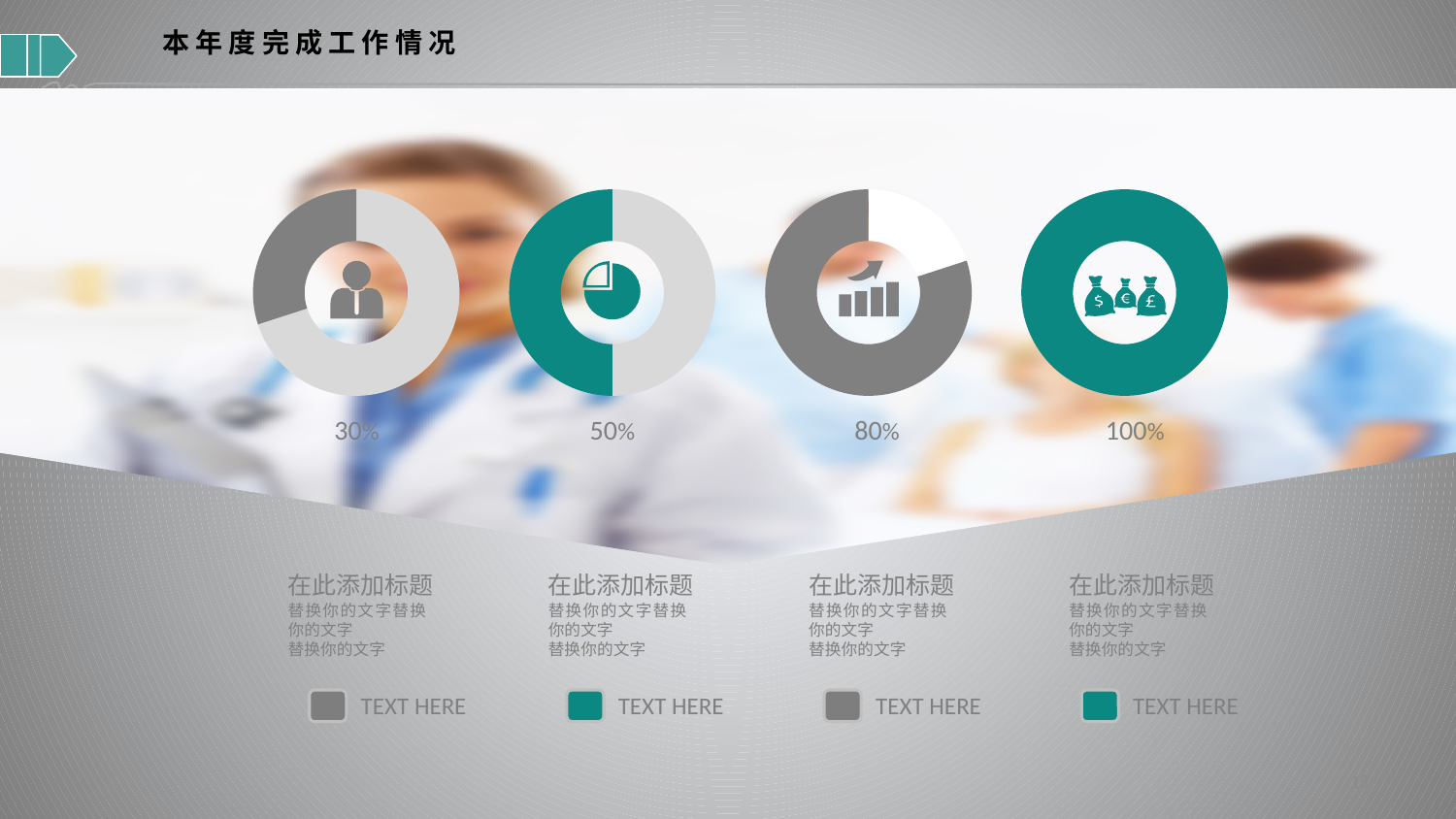
What percentage is shown under the third donut chart from the left? 80% How many donut charts are on the slide? 4 What percentage is shown under the leftmost donut chart? 30% Which donut chart shows the lowest percentage? The leftmost one (30%) Which donut chart shows the highest percentage? The rightmost one (100%) What kind of charts are shown on the slide? Donut charts What is the title of the slide containing the donut charts? 本年度完成工作情况 What percentage is shown under the second donut chart from the left? 50% Which is larger, the percentage of the second donut chart or the third donut chart? The third (80%) What is the difference between the percentages of the third and the first donut charts? 50% What percentage is shown under the rightmost donut chart? 100% Do the percentages increase or decrease from left to right across the four donut charts? Increase